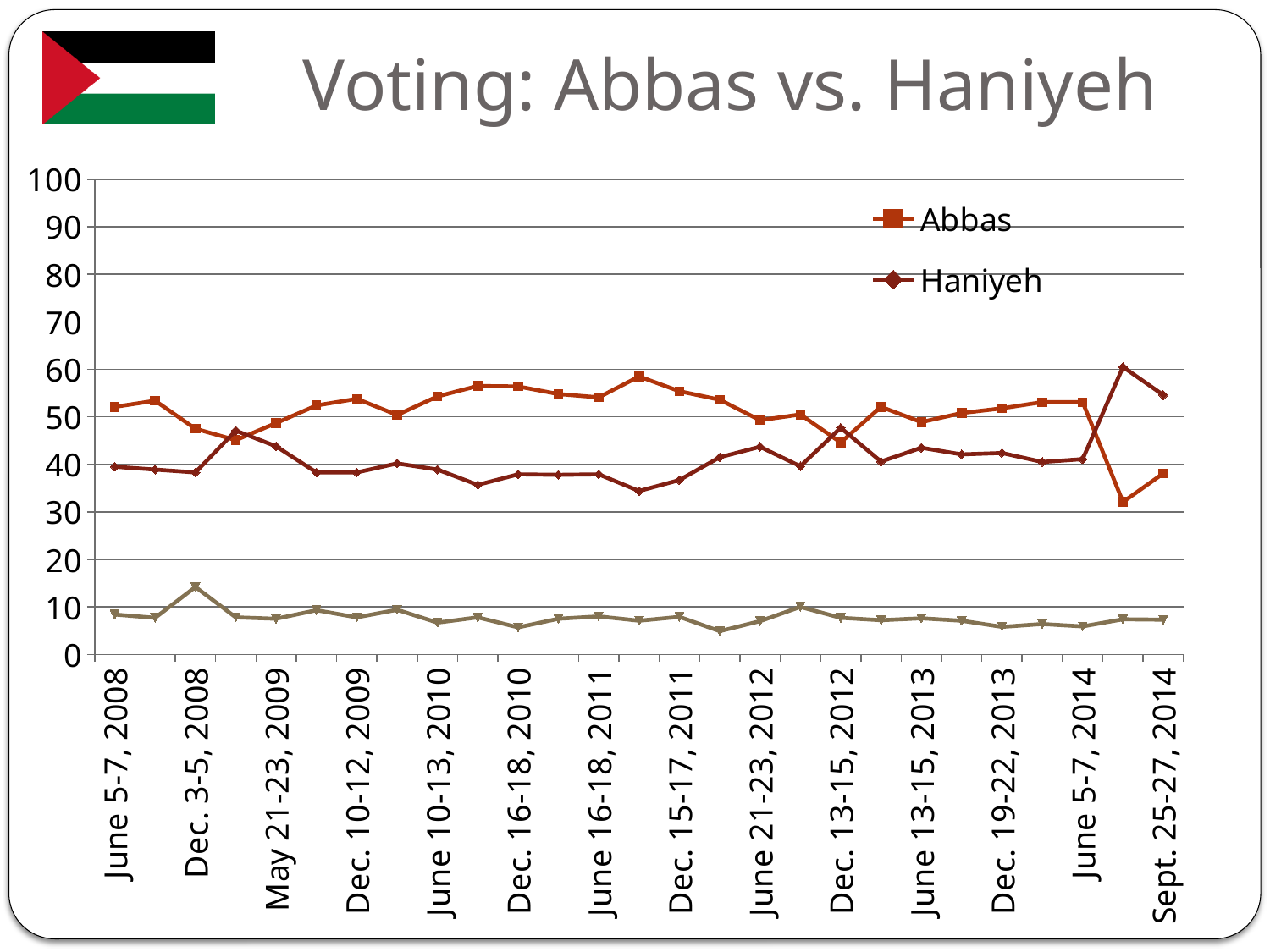
Is the value for Abbas at Sept. 25-27, 2014 greater or less than 40? less Is the value for Haniyeh at June 5-7, 2008 greater or less than 30? greater Which two series are named in the legend? Abbas and Haniyeh Is the value for Abbas at June 10-13, 2010 greater or less than 50? greater What is the title of the chart? Voting: Abbas vs. Haniyeh At June 16-18, 2011, which series has the higher value, Abbas or Haniyeh? Abbas At Sept. 25-27, 2014, which series has the higher value, Abbas or Haniyeh? Haniyeh How many date labels are shown along the x axis? 14 How many series does the legend list? 2 Does the Abbas line rise or fall from June 5-7, 2008 to Dec. 3-5, 2008? fall What kind of chart is shown on the slide? line chart